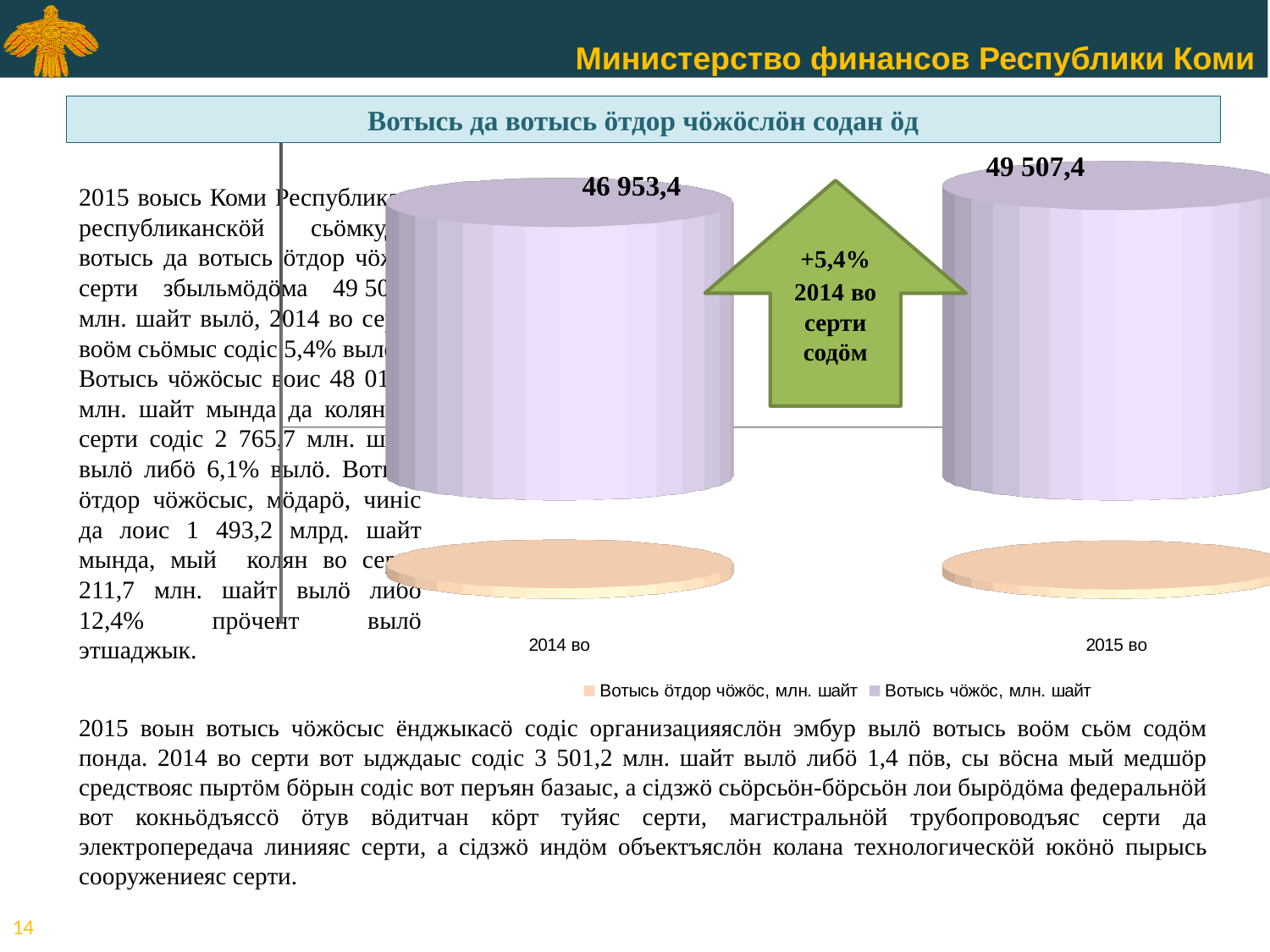
What value is labelled on the bar for 2015 во? 49 507,4 What kind of chart is shown on the slide? bar chart What percentage change is written inside the arrow between the two bars? +5,4% Which category has the higher labelled value, 2014 во or 2015 во? 2015 во What is the difference between the labelled values for 2015 во and 2014 во? 2 554,0 What value is labelled on the bar for 2014 во? 46 953,4 What is the title of the chart? Вотысь да вотысь öтдор чöжöслöн содан öд How many categories are shown on the x axis of the chart? 2 Do the labelled values rise or fall from 2014 во to 2015 во? rise In the 2014 во bar, which series is larger: Вотысь öтдор чöжöс or Вотысь чöжöс? Вотысь чöжöс, млн. шайт How many series does the chart legend list? 2